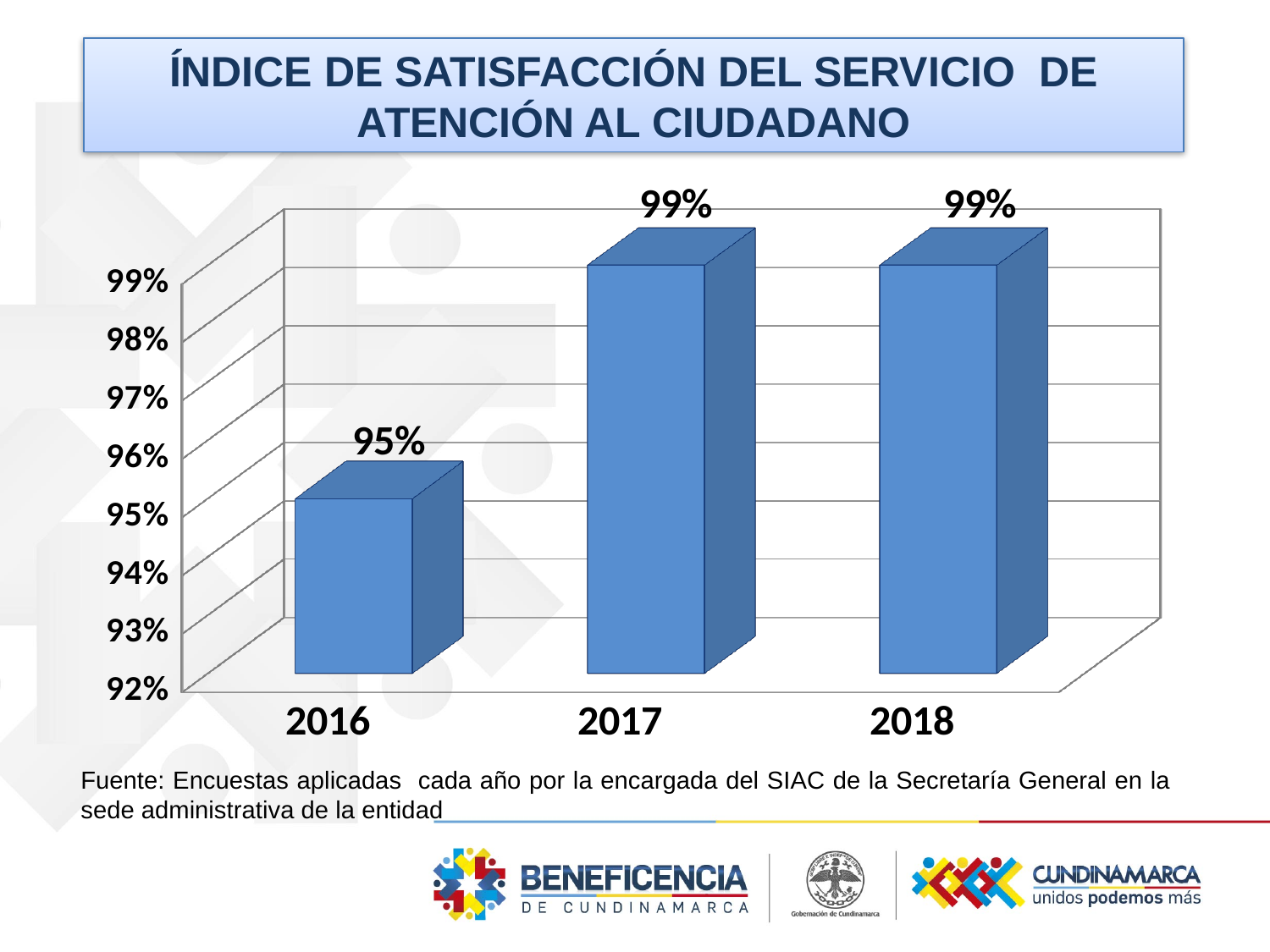
Which year has the lowest satisfaction index? 2016 Which is larger, the value for 2016 or the value for 2018? 2018 Is the value for 2016 greater or less than 97%? less What is the difference between the 2017 value and the 2016 value? 4% Do the values rise or fall from 2016 to 2017? rise What is the satisfaction index value for 2018? 99% What is the title of the chart on the slide? ÍNDICE DE SATISFACCIÓN DEL SERVICIO DE ATENCIÓN AL CIUDADANO What kind of chart is shown on the slide? bar chart What is the satisfaction index value for 2016? 95% What is the lowest value shown on the vertical axis of the chart? 92% What is the satisfaction index value for 2017? 99% How many years are shown on the x axis of the chart? 3